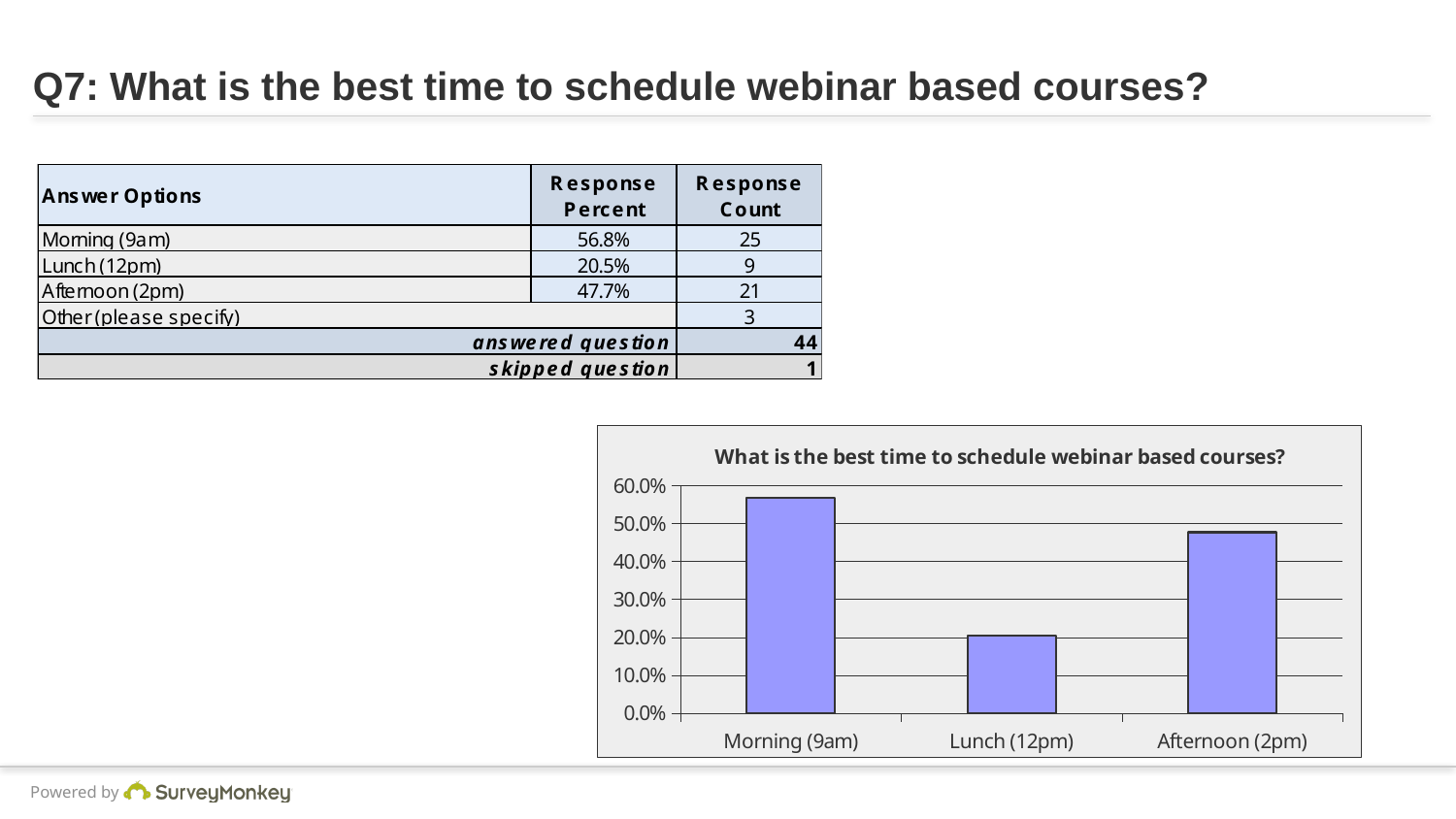
What is the response percent for Lunch (12pm)? 20.5% How many categories are plotted on the chart? 3 Which category has the highest bar in the chart? Morning (9am) Is the value for Afternoon (2pm) greater or less than 40.0%? greater What is the response percent for Morning (9am)? 56.8% Is the value for Lunch (12pm) greater or less than 30.0%? less Which is larger, the value for Morning (9am) or the value for Afternoon (2pm)? Morning (9am) What type of chart is shown on the slide? bar chart What is the response percent for Afternoon (2pm)? 47.7% What is the title of the chart? What is the best time to schedule webinar based courses? What is the difference between the response percent for Morning (9am) and Lunch (12pm)? 36.3% Which category has the lowest bar in the chart? Lunch (12pm)